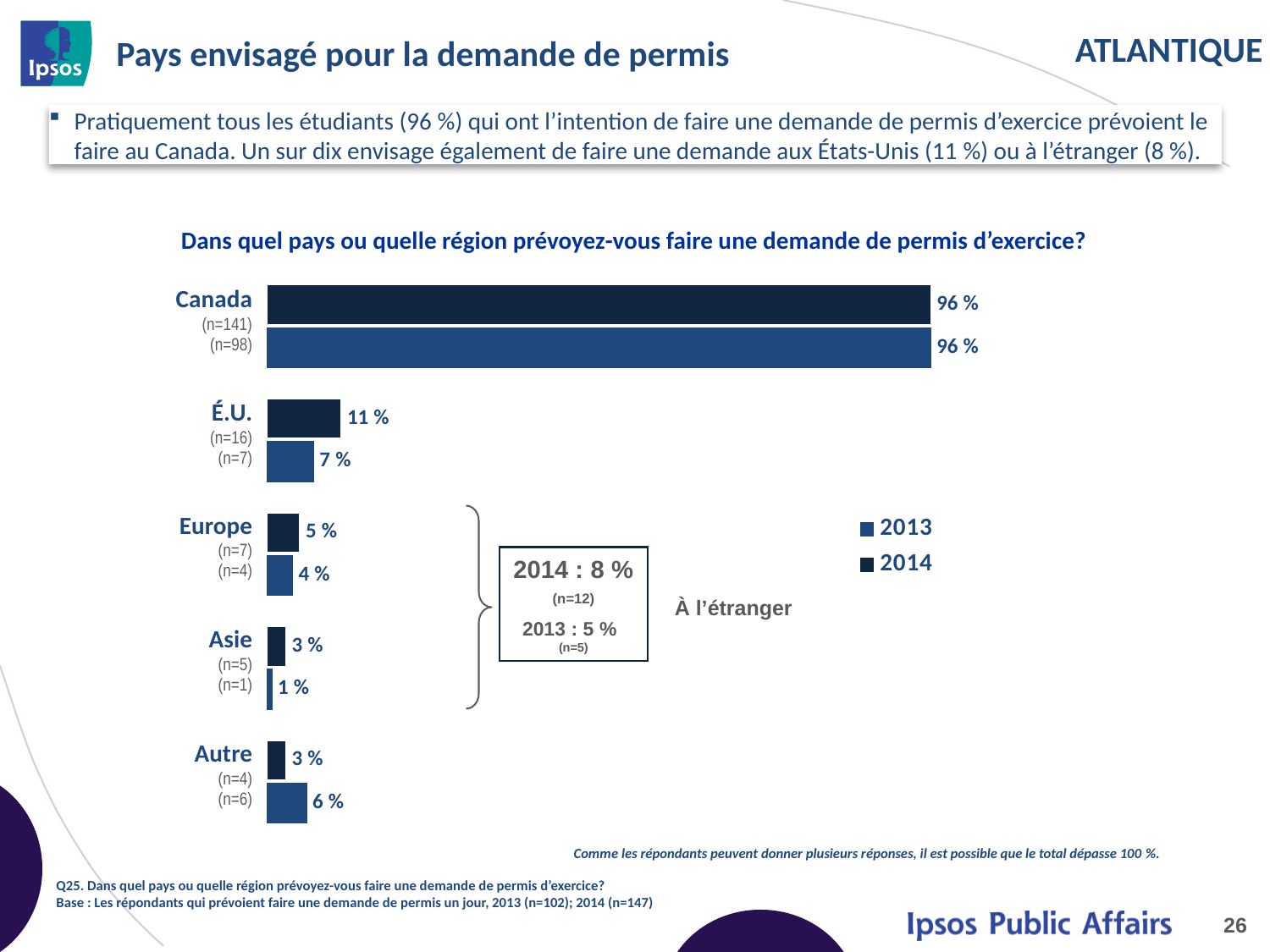
What is the 2013 value for Autre? 6 % What is the title of the chart? Dans quel pays ou quelle région prévoyez-vous faire une demande de permis d'exercice? How many countries/regions are listed as categories in the chart? 5 What is the 2013 value for É.U.? 7 % What is the difference between the 2014 and 2013 values for É.U.? 4 % What is the 2014 value for Canada? 96 % For Autre, which year has the larger value, 2013 or 2014? 2013 What type of chart is shown on the slide? bar chart What is the 2014 value for É.U.? 11 % Which category has the highest value in 2014? Canada How many series does the legend list? 2 Which category has the lowest value in 2013? Asie